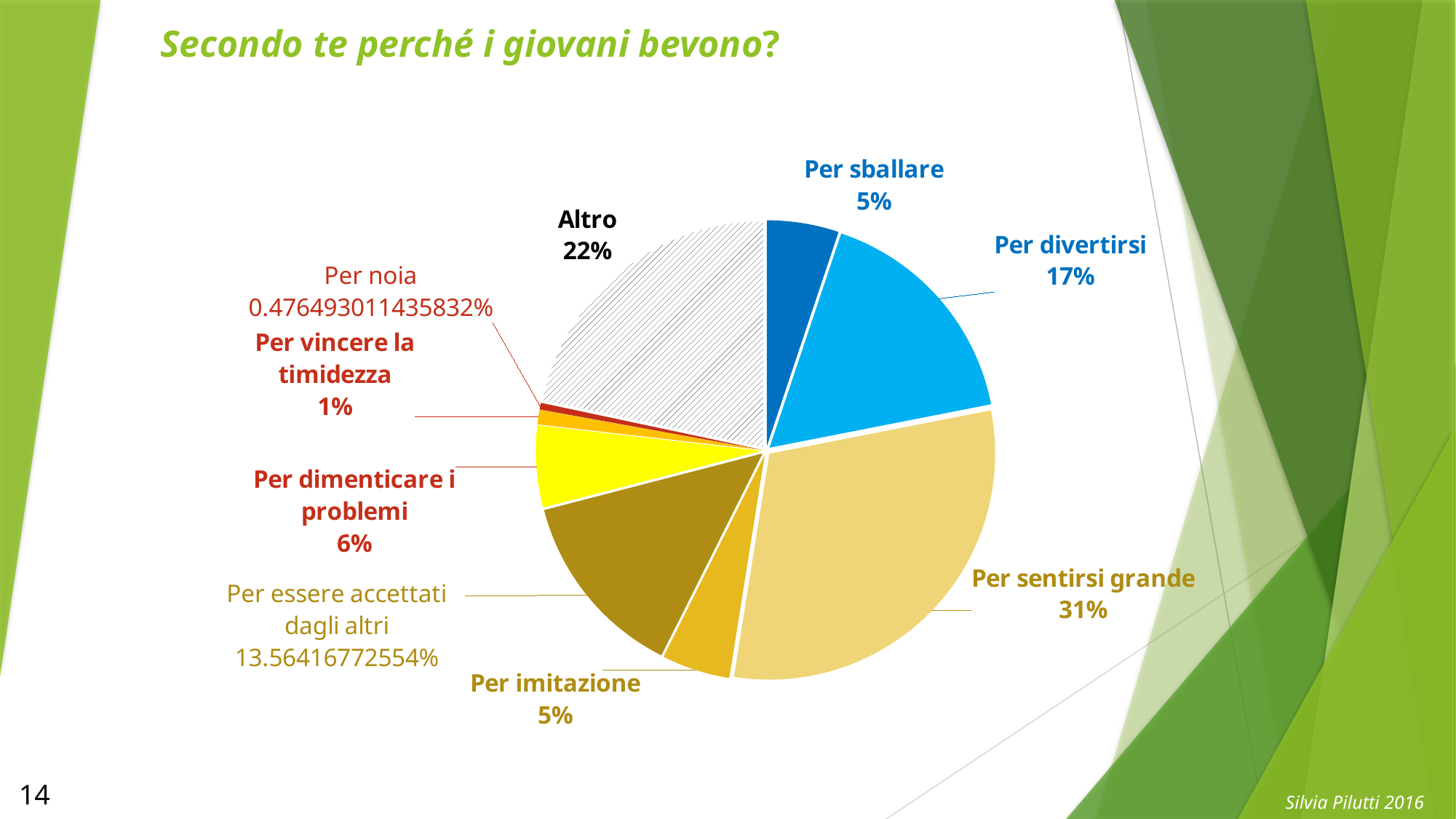
Which category has the smallest share of the pie? Per noia Which is larger, the share for "Per divertirsi" or the share for "Per dimenticare i problemi"? Per divertirsi What is the title of the slide containing the chart? Secondo te perché i giovani bevono? What kind of chart is shown on the slide? Pie chart What percentage of the pie is labelled "Per sentirsi grande"? 31% What value is shown for "Per noia"? 0.476493011435832% How many categories (slices) does the pie chart have? 9 Which category has the largest share of the pie? Per sentirsi grande What is the difference between the shares of "Per sentirsi grande" and "Altro"? 9% What value is shown for "Per divertirsi"? 17% Which slice of the pie is drawn with a hatched (striped) pattern? Altro What value is shown for "Per essere accettati dagli altri"? 13.56416772554%